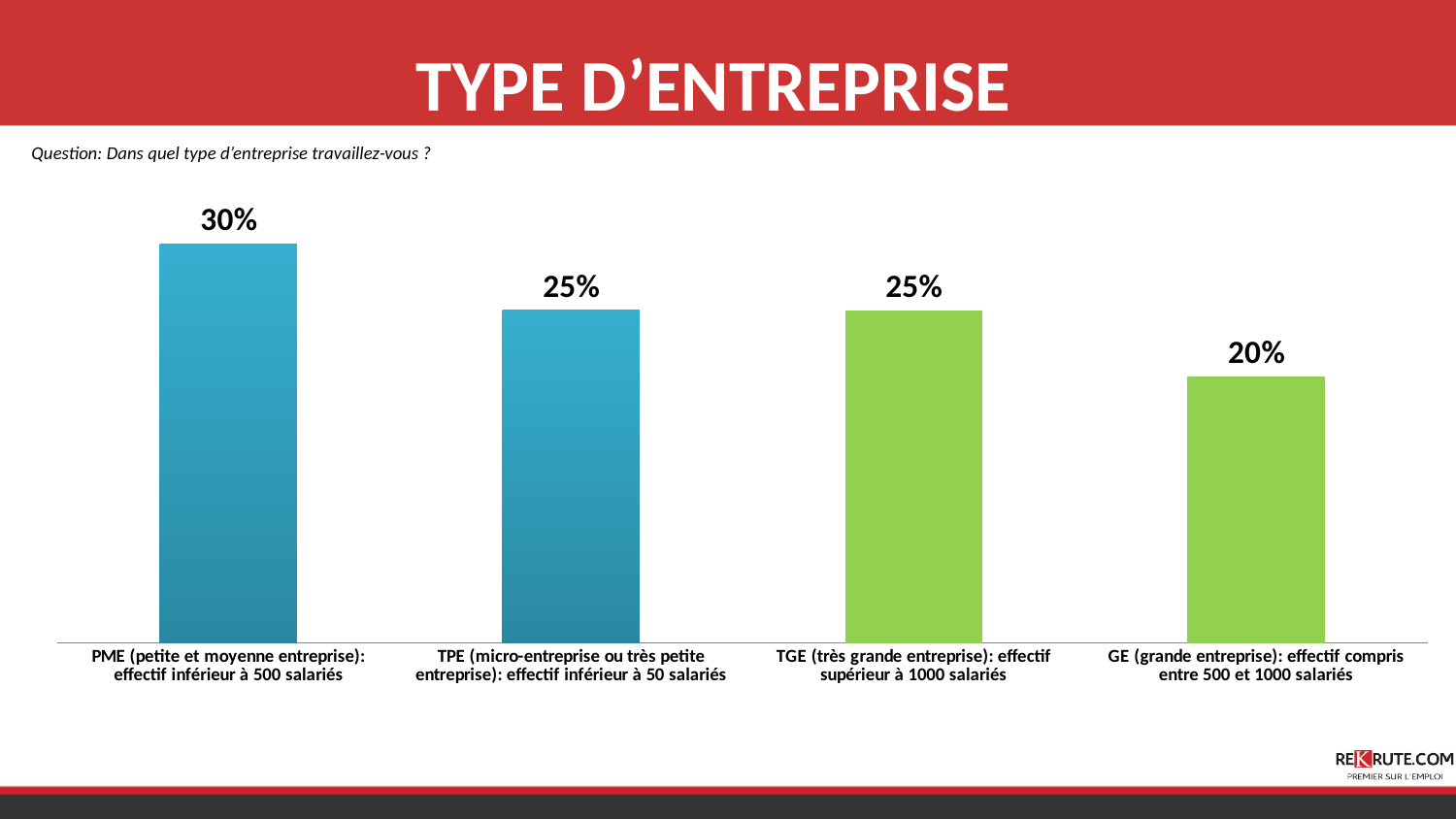
What is the total of the TPE and TGE values? 50% Which is larger, the value for TGE or the value for GE? TGE What colour are the bars for TGE and GE? Green Which type of company has the highest percentage? PME (petite et moyenne entreprise) What is the difference between the PME value and the GE value? 10% Which type of company has the lowest percentage? GE (grande entreprise) How many company types are shown in the chart? 4 What percentage is shown for TPE (micro-entreprise ou très petite entreprise)? 25% What is the title of the slide? TYPE D'ENTREPRISE What percentage of respondents work in a PME (petite et moyenne entreprise)? 30% What kind of chart is shown on the slide? Bar chart What is the value shown for GE (grande entreprise)? 20%